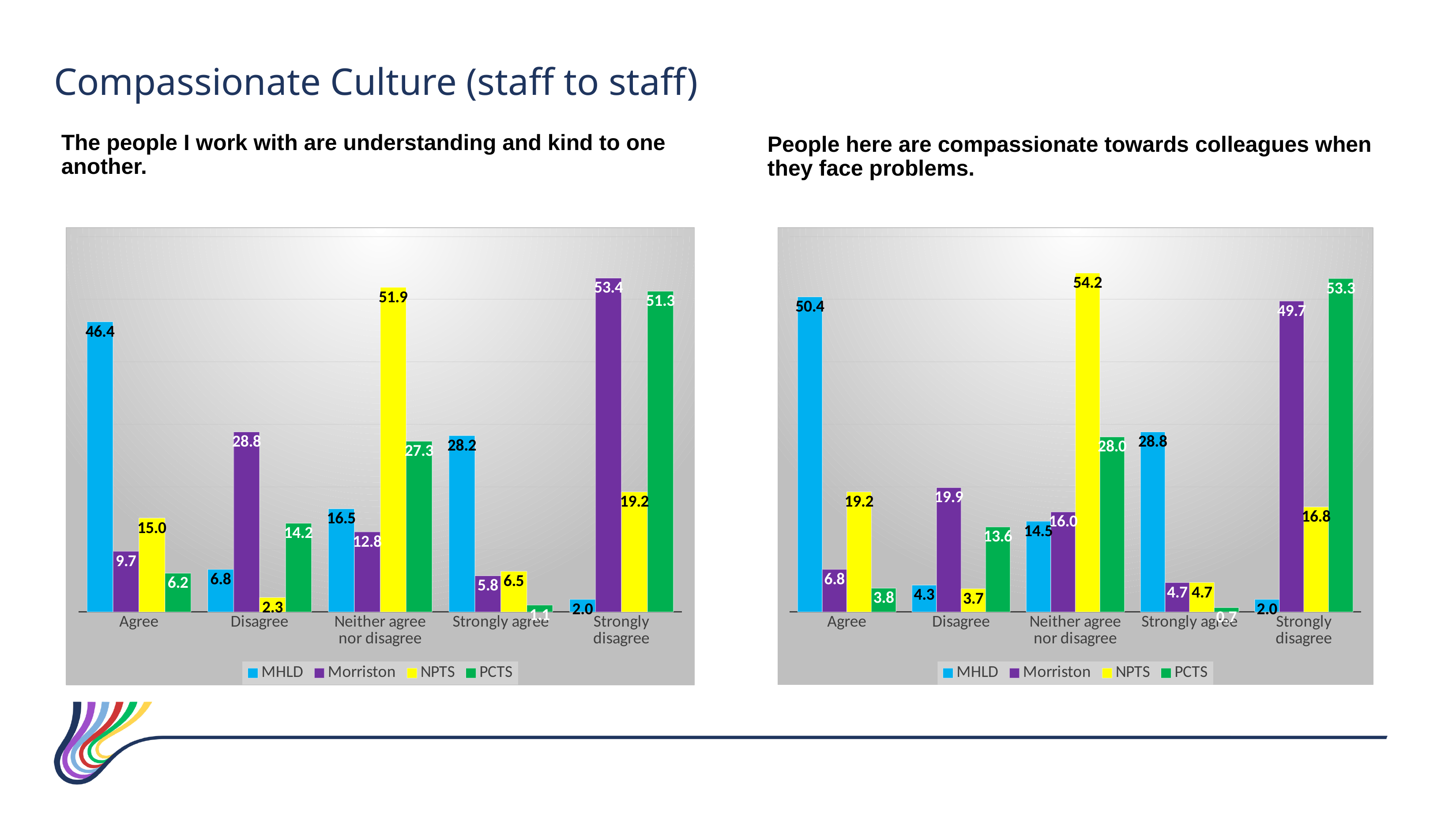
In the right chart ("People here are compassionate towards colleagues when they face problems"), what is the value for MHLD in the Agree category? 50.4 In the left chart ("The people I work with are understanding and kind to one another"), what is the difference between the Morriston and NPTS values in the Disagree category? 26.5 In the left chart ("The people I work with are understanding and kind to one another"), which series has the lowest value in the Strongly agree category? PCTS In the right chart ("People here are compassionate towards colleagues when they face problems"), is the Morriston value or the PCTS value larger in the Disagree category? Morriston In the right chart ("People here are compassionate towards colleagues when they face problems"), how many series does the legend list? 4 What kind of chart is the right chart ("People here are compassionate towards colleagues when they face problems")? Bar chart In the left chart ("The people I work with are understanding and kind to one another"), which series has the highest value in the Strongly disagree category? Morriston In the left chart ("The people I work with are understanding and kind to one another"), what is the value for NPTS in the Neither agree nor disagree category? 51.9 In the right chart ("People here are compassionate towards colleagues when they face problems"), what is the value for PCTS in the Strongly disagree category? 53.3 In the right chart ("People here are compassionate towards colleagues when they face problems"), which series has the highest value in the Neither agree nor disagree category? NPTS In the left chart ("The people I work with are understanding and kind to one another"), how many categories are shown on the x axis? 5 In the left chart ("The people I work with are understanding and kind to one another"), what is the value for MHLD in the Agree category? 46.4